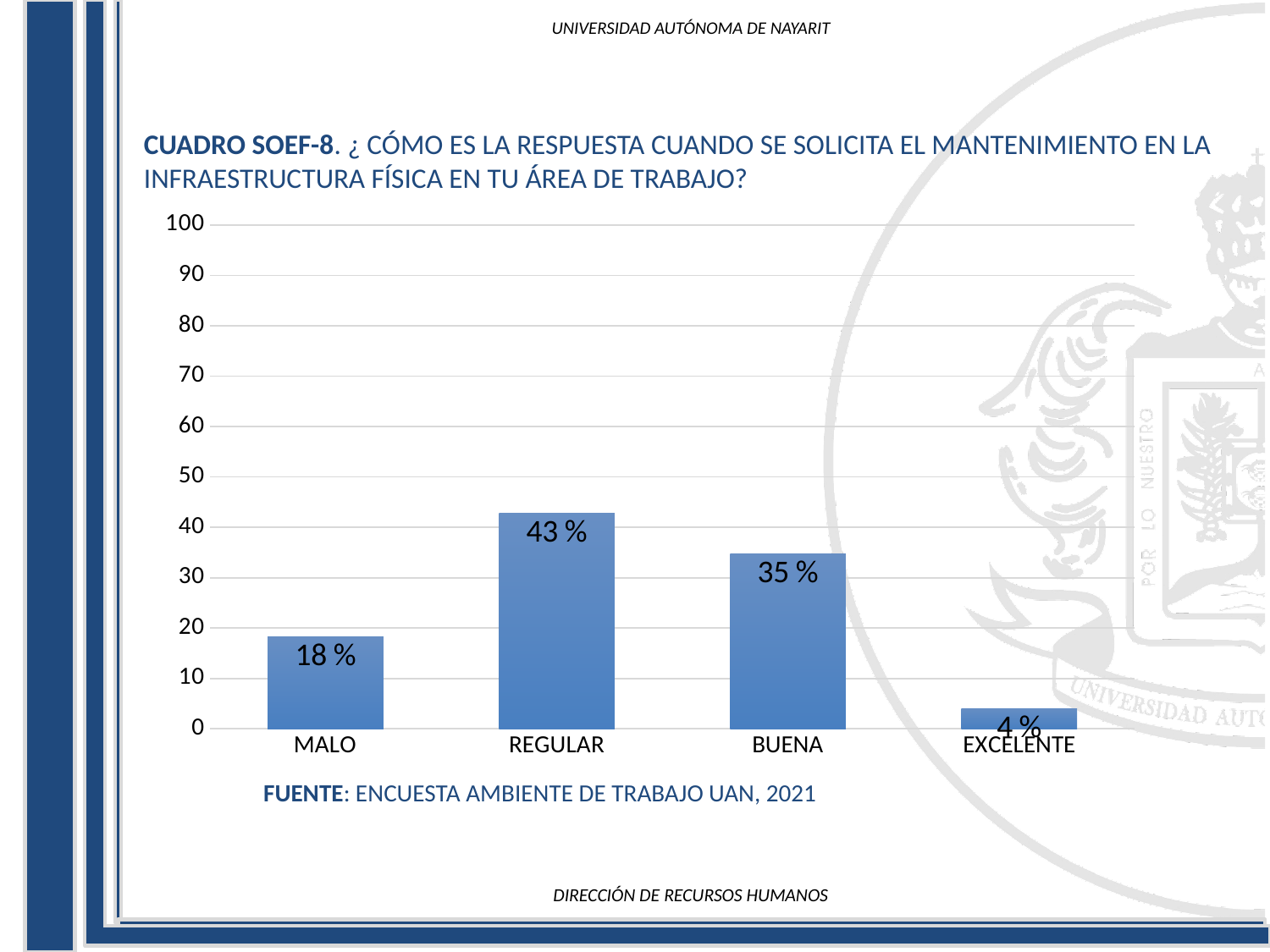
Which category has the lowest value? EXCELENTE Which is larger, the value for MALO or the value for BUENA? BUENA What is the value for EXCELENTE? 4 % Is the value for REGULAR greater or less than 40? greater What kind of chart is shown on the slide? bar chart What source is cited below the chart? ENCUESTA AMBIENTE DE TRABAJO UAN, 2021 What is the difference between the values for REGULAR and BUENA? 8 % How many categories are shown on the x axis? 4 Which category has the highest value? REGULAR What is the value for REGULAR? 43 % What is the value for MALO? 18 % What is the value for BUENA? 35 %